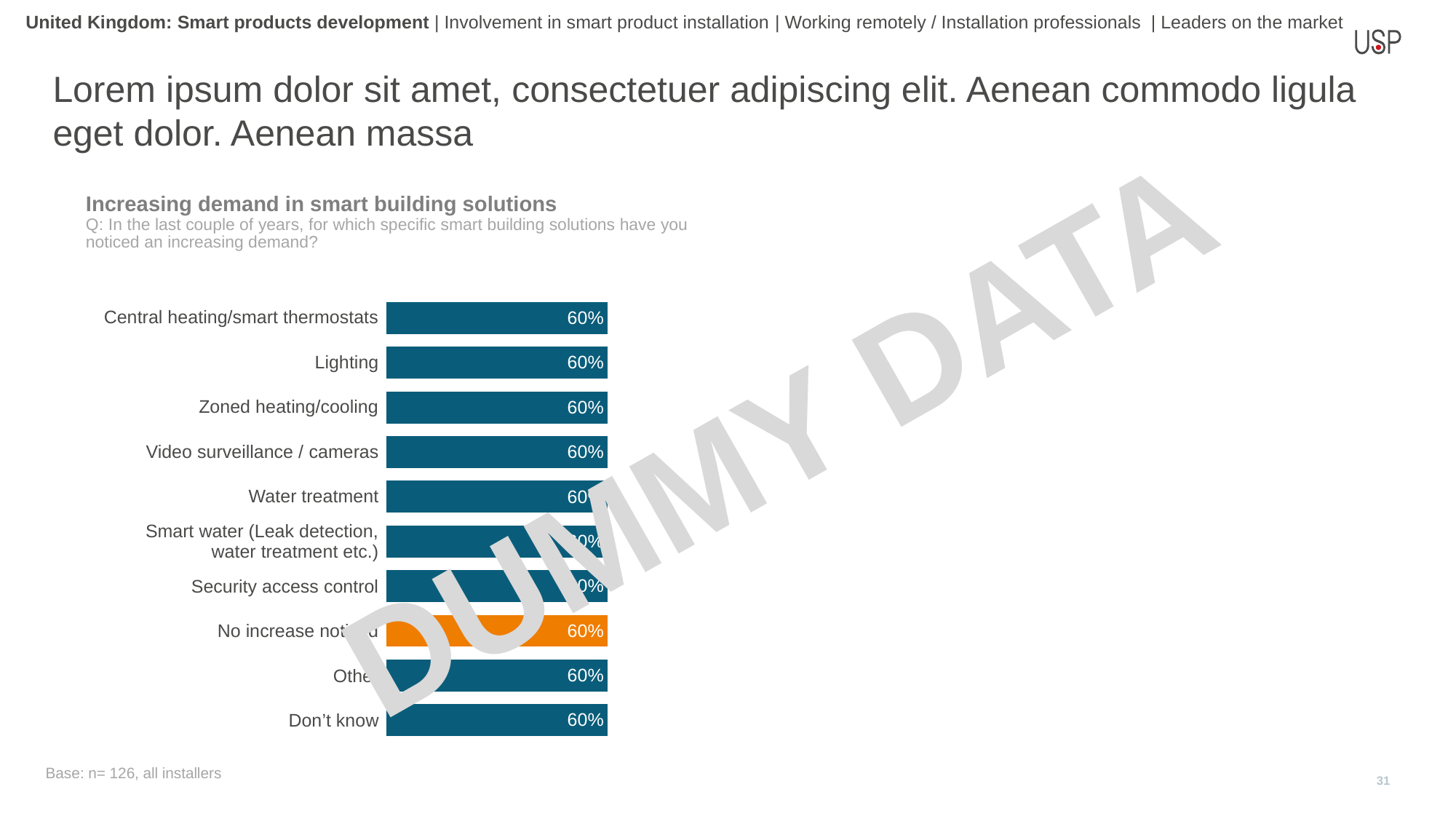
What is the value for Don't know? 60% What is the value for Lighting? 60% What is the difference between the values for Lighting and Don't know? 0% What is the value for Zoned heating/cooling? 60% How many bars in the chart are coloured orange rather than blue? 1 What kind of chart is shown on the slide? bar chart What is the value for Video surveillance / cameras? 60% What is the title of the chart? Increasing demand in smart building solutions How many categories are plotted in the chart? 10 What is the value for Central heating/smart thermostats? 60%